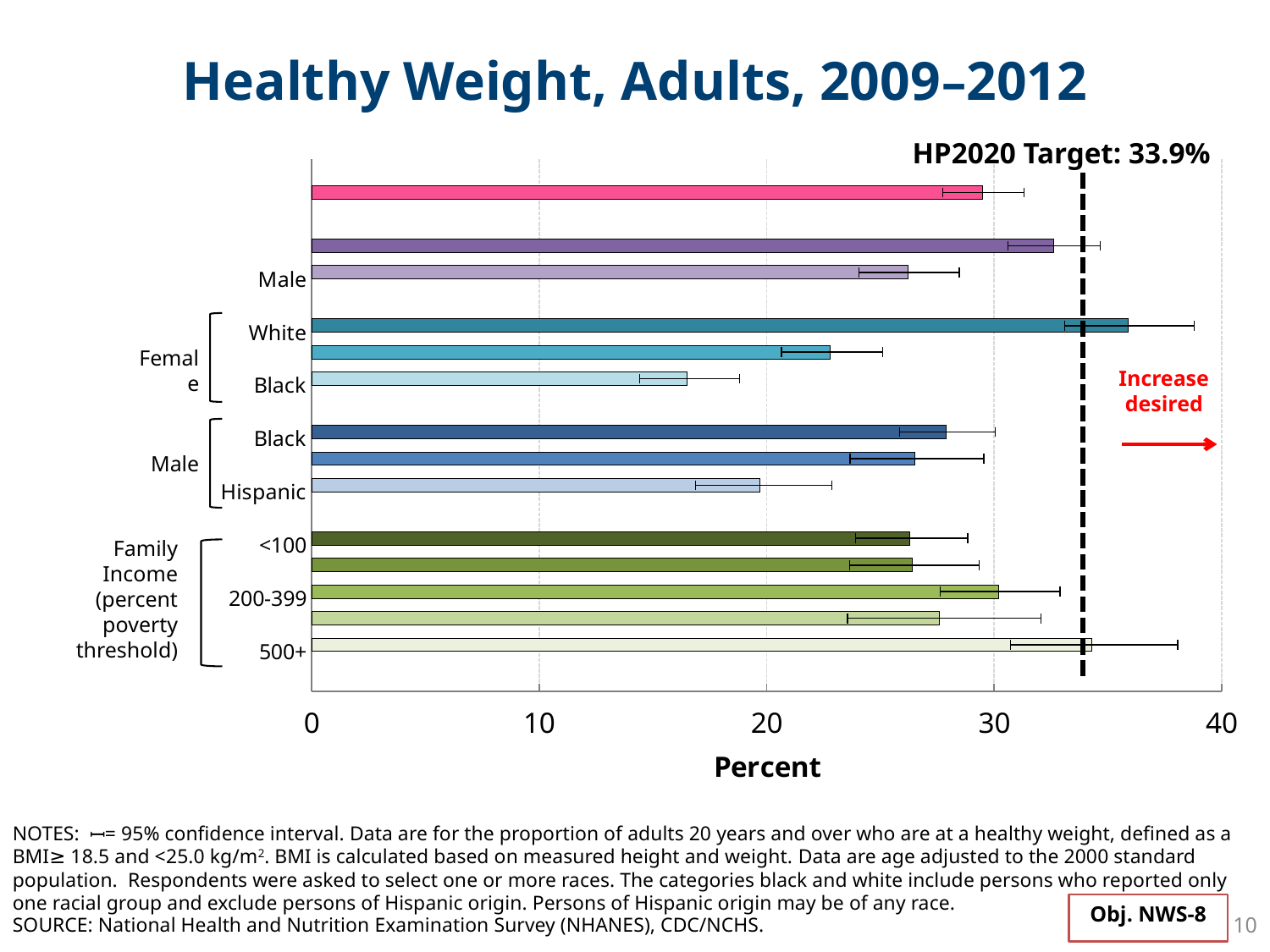
Which is larger, the value for the 500+ family income group or the value for the <100 family income group? 500+ Is the value for Female White greater or less than 30? greater What kind of chart is shown on the slide? bar chart Which group has the highest healthy weight percentage on the chart? Female White What is the HP2020 Target value shown on the chart? 33.9% Is the value for Female Black greater or less than 20? less What is the title of the chart? Healthy Weight, Adults, 2009–2012 Which group has the lowest healthy weight percentage on the chart? Female Black How many bars are plotted on the chart? 14 Which is larger, the value for Male Black or the value for Male Hispanic? Male Black Is the value for the 500+ family income group greater or less than 30? greater